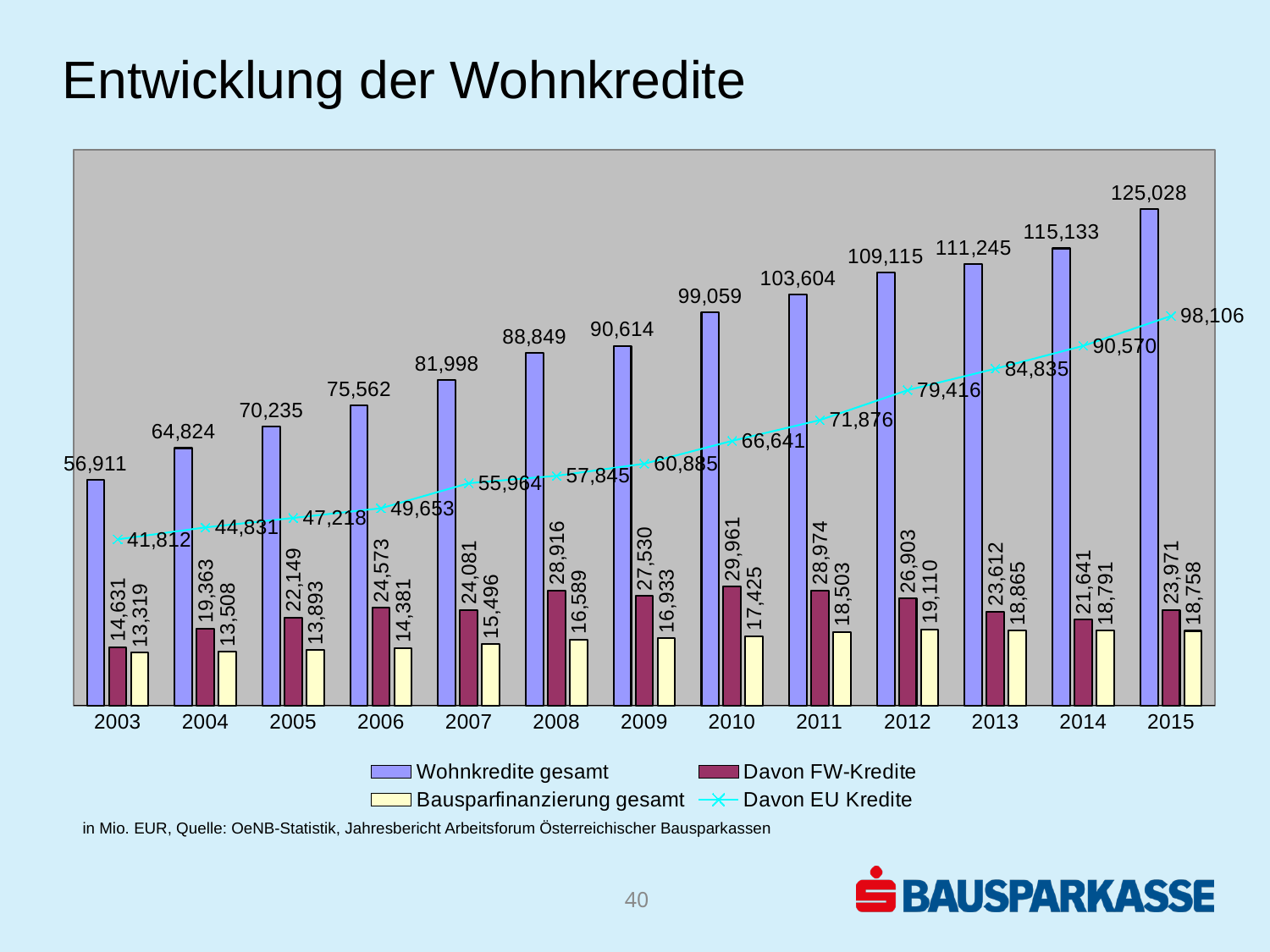
What is the value of Davon FW-Kredite in 2012? 26,903 How many series does the legend list? 4 How many years are shown on the x axis? 13 What is the value of Wohnkredite gesamt in 2015? 125,028 Which series is drawn as a line with x markers? Davon EU Kredite What is the value of Bausparfinanzierung gesamt in 2008? 16,589 Does Davon EU Kredite rise or fall from 2003 to 2015? rise What is the difference between Wohnkredite gesamt in 2015 and in 2003? 68,117 Which is larger in 2007: Davon FW-Kredite or Bausparfinanzierung gesamt? Davon FW-Kredite In which year is Bausparfinanzierung gesamt lowest? 2003 What is the value of Davon EU Kredite in 2003? 41,812 In which year is Davon FW-Kredite highest? 2010